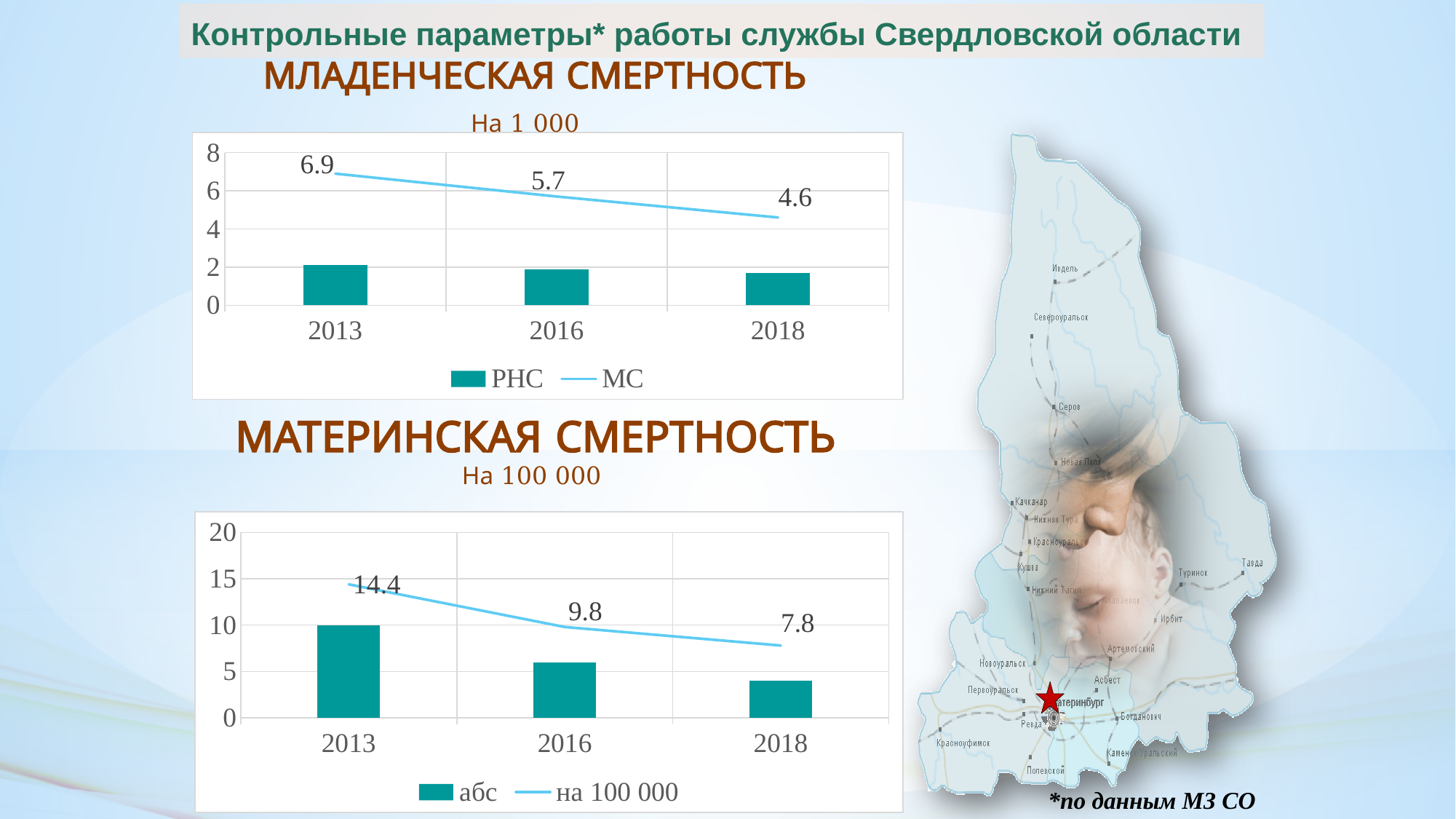
In the МЛАДЕНЧЕСКАЯ СМЕРТНОСТЬ chart, does the МС line rise or fall from 2013 to 2018? fall In the МАТЕРИНСКАЯ СМЕРТНОСТЬ chart, is the абс bar for 2013 greater or less than 5? greater In the МАТЕРИНСКАЯ СМЕРТНОСТЬ chart, is the абс bar for 2018 greater or less than 5? less In the МЛАДЕНЧЕСКАЯ СМЕРТНОСТЬ chart, what is the МС value for 2018? 4.6 In the МЛАДЕНЧЕСКАЯ СМЕРТНОСТЬ chart, what is the МС value for 2013? 6.9 In the МАТЕРИНСКАЯ СМЕРТНОСТЬ chart, what is the 'на 100 000' value for 2016? 9.8 In the МАТЕРИНСКАЯ СМЕРТНОСТЬ chart, what is the difference between the 'на 100 000' values for 2013 and 2018? 6.6 How many series does the legend of the МЛАДЕНЧЕСКАЯ СМЕРТНОСТЬ chart list? 2 How many years are shown on the x axis of the МАТЕРИНСКАЯ СМЕРТНОСТЬ chart? 3 In the МЛАДЕНЧЕСКАЯ СМЕРТНОСТЬ chart, which year has the lowest МС value? 2018 In the МАТЕРИНСКАЯ СМЕРТНОСТЬ chart, which year has the highest 'на 100 000' value? 2013 In the МЛАДЕНЧЕСКАЯ СМЕРТНОСТЬ chart, what is the difference between the МС values for 2013 and 2018? 2.3